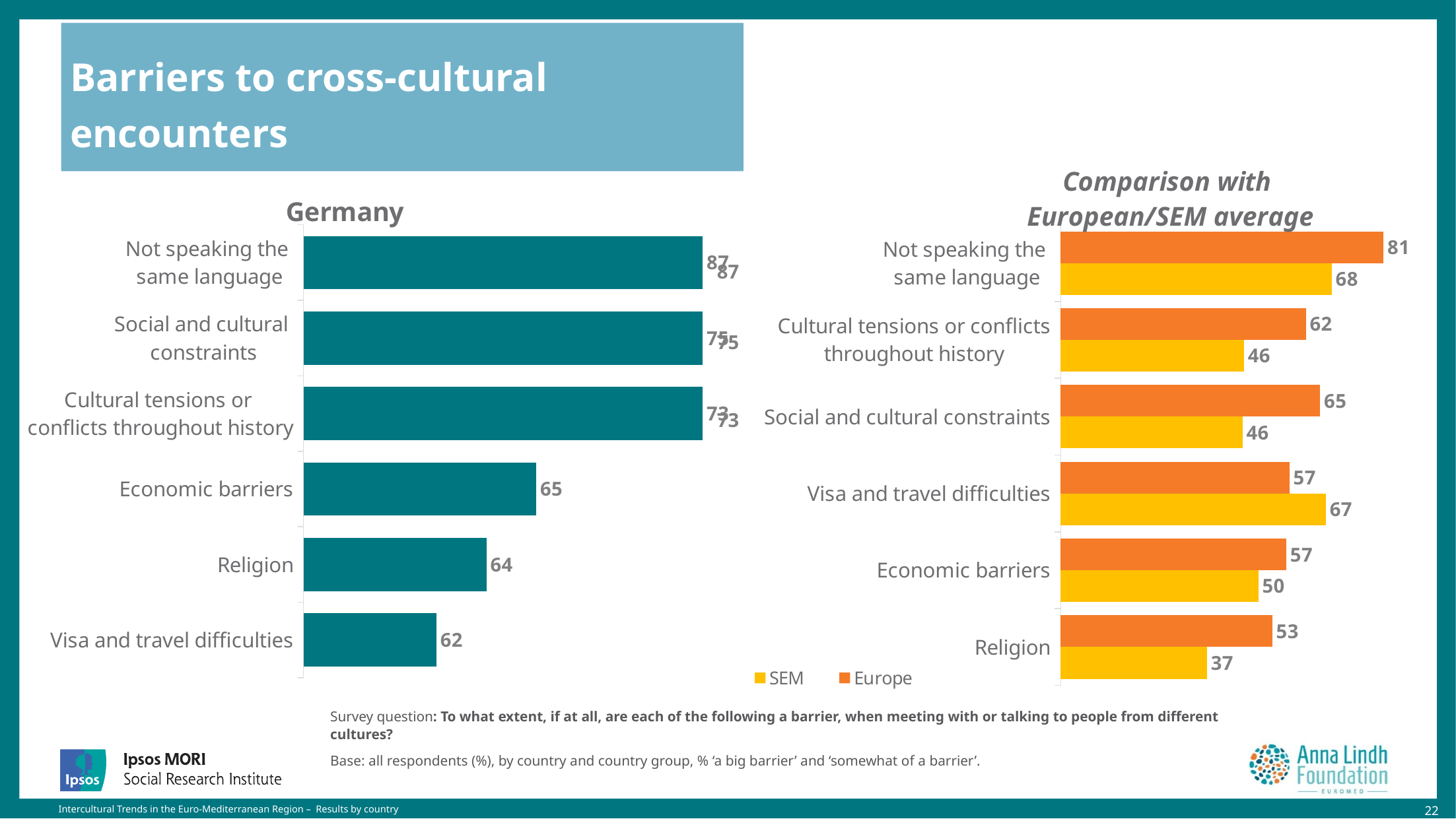
In the Comparison with European/SEM average chart, what is the difference between the Europe and SEM values for Cultural tensions or conflicts throughout history? 16 In the Germany chart, what is the difference between Not speaking the same language and Religion? 23 In the Germany chart, what is the value for Visa and travel difficulties? 62 In the Comparison with European/SEM average chart, which is larger for Visa and travel difficulties, SEM or Europe? SEM In the Germany chart, how many barriers are listed? 6 In the Germany chart, which barrier has the highest value? Not speaking the same language In the Germany chart, what is the value for Economic barriers? 65 In the Comparison with European/SEM average chart, what is the Europe value for Not speaking the same language? 81 What kind of chart is the Germany chart? Bar chart In the Germany chart, which barrier has the lowest value? Visa and travel difficulties In the Comparison with European/SEM average chart, what is the SEM value for Religion? 37 How many series does the legend of the Comparison with European/SEM average chart list? 2